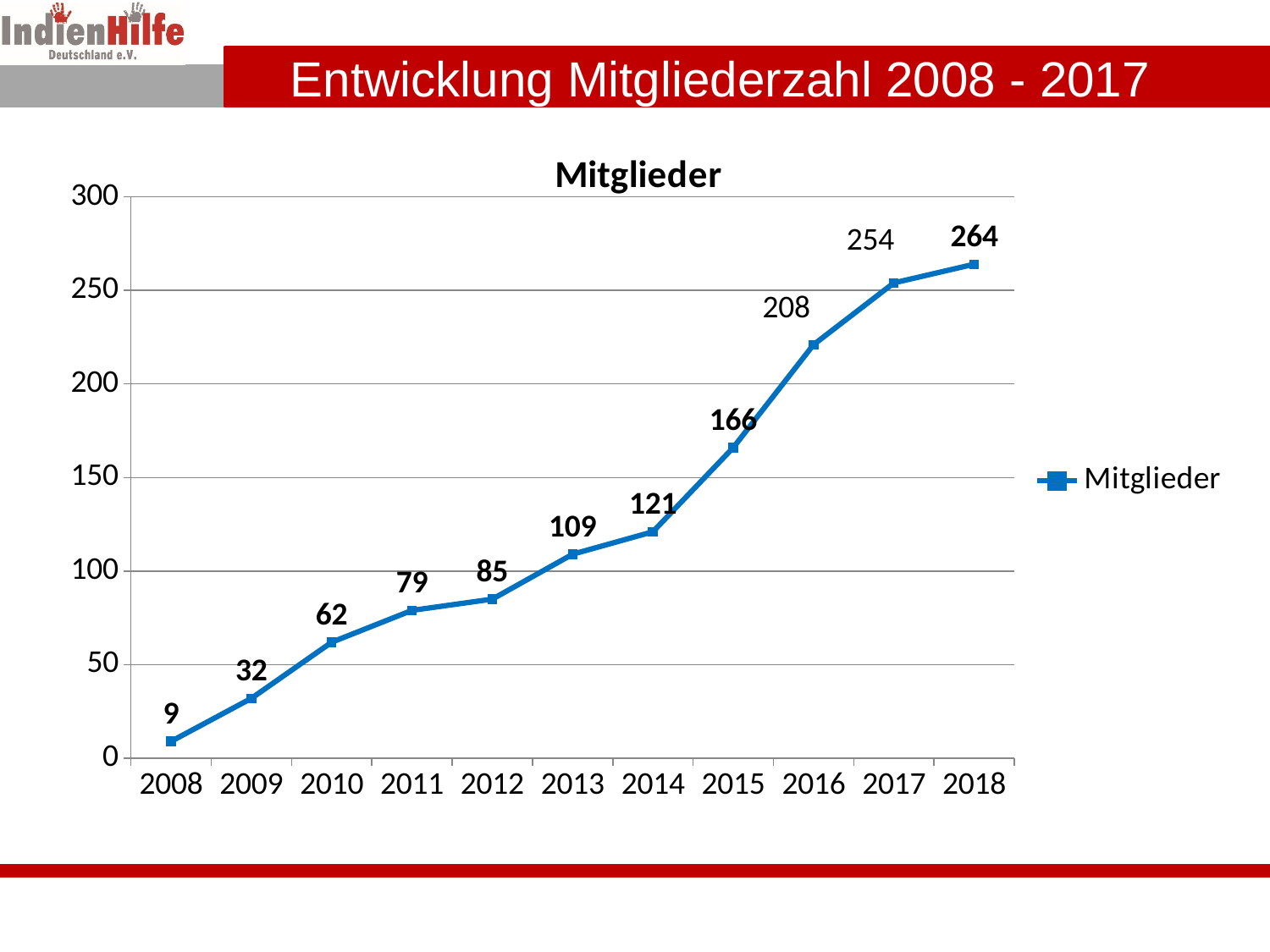
What is the value for 2013? 109 Which year has the lowest value? 2008 What is the value for 2018? 264 Do the values rise or fall from 2008 to 2018? rise What is the value for 2016? 208 How many years are plotted on the x axis? 11 What is the difference between the values for 2017 and 2016? 46 What is the value for 2008? 9 Is the value for 2015 greater or less than 150? greater Which year has the highest value? 2018 What kind of chart is shown? line chart Which is larger, the value for 2011 or the value for 2012? 2012